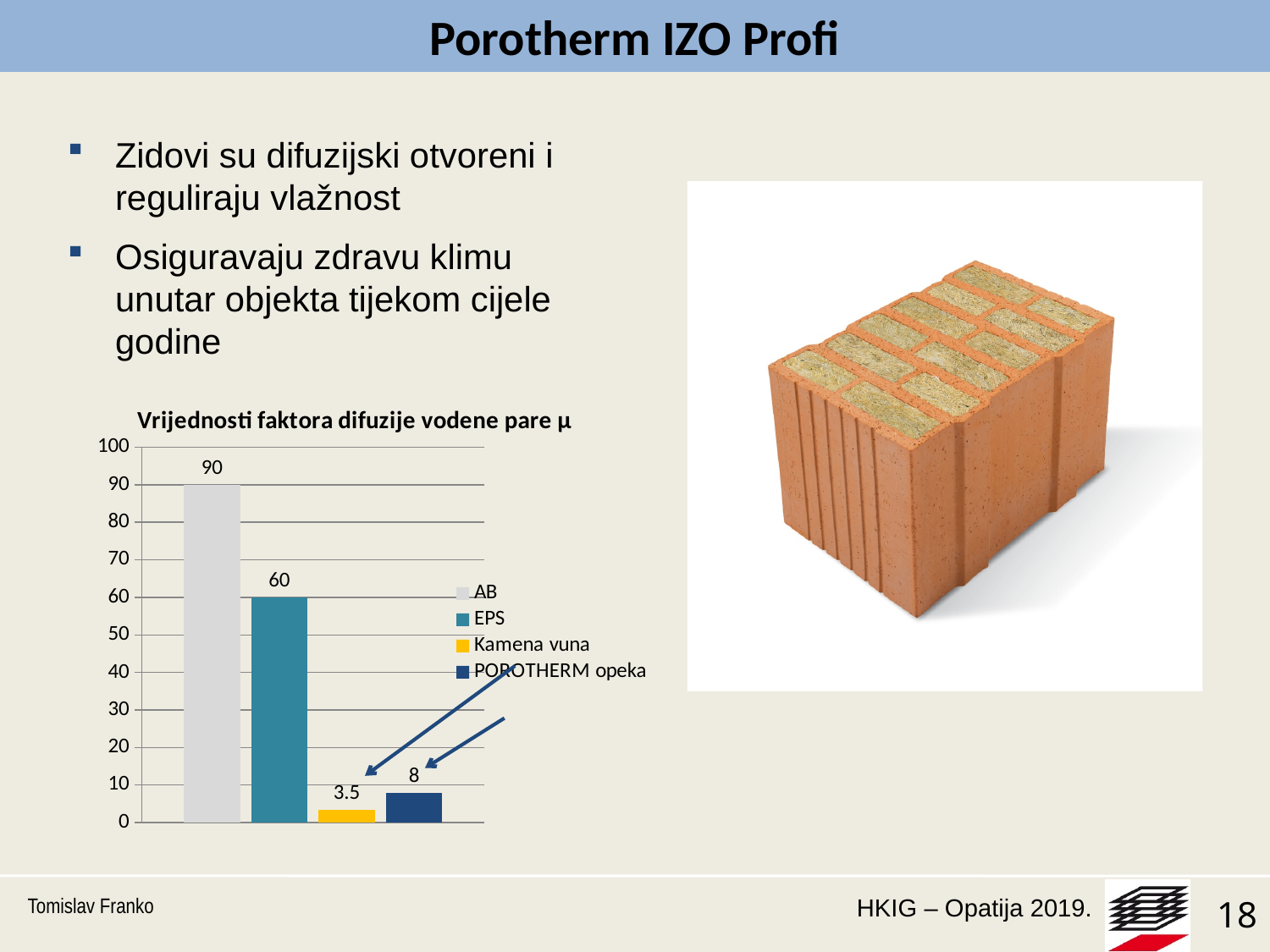
What is the difference between the values for POROTHERM opeka and Kamena vuna? 4.5 Which series has the lowest value in the chart? Kamena vuna What is the difference between the values for AB and EPS? 30 What kind of chart is shown on the slide? Bar chart What is the value for EPS in the chart? 60 What is the value for POROTHERM opeka in the chart? 8 What is the value for AB in the chart 'Vrijednosti faktora difuzije vodene pare μ'? 90 Which series has the highest value in the chart? AB What is the title of the chart? Vrijednosti faktora difuzije vodene pare μ Which is larger, the value for EPS or the value for POROTHERM opeka? EPS What is the value for Kamena vuna in the chart? 3.5 How many series does the legend list? 4